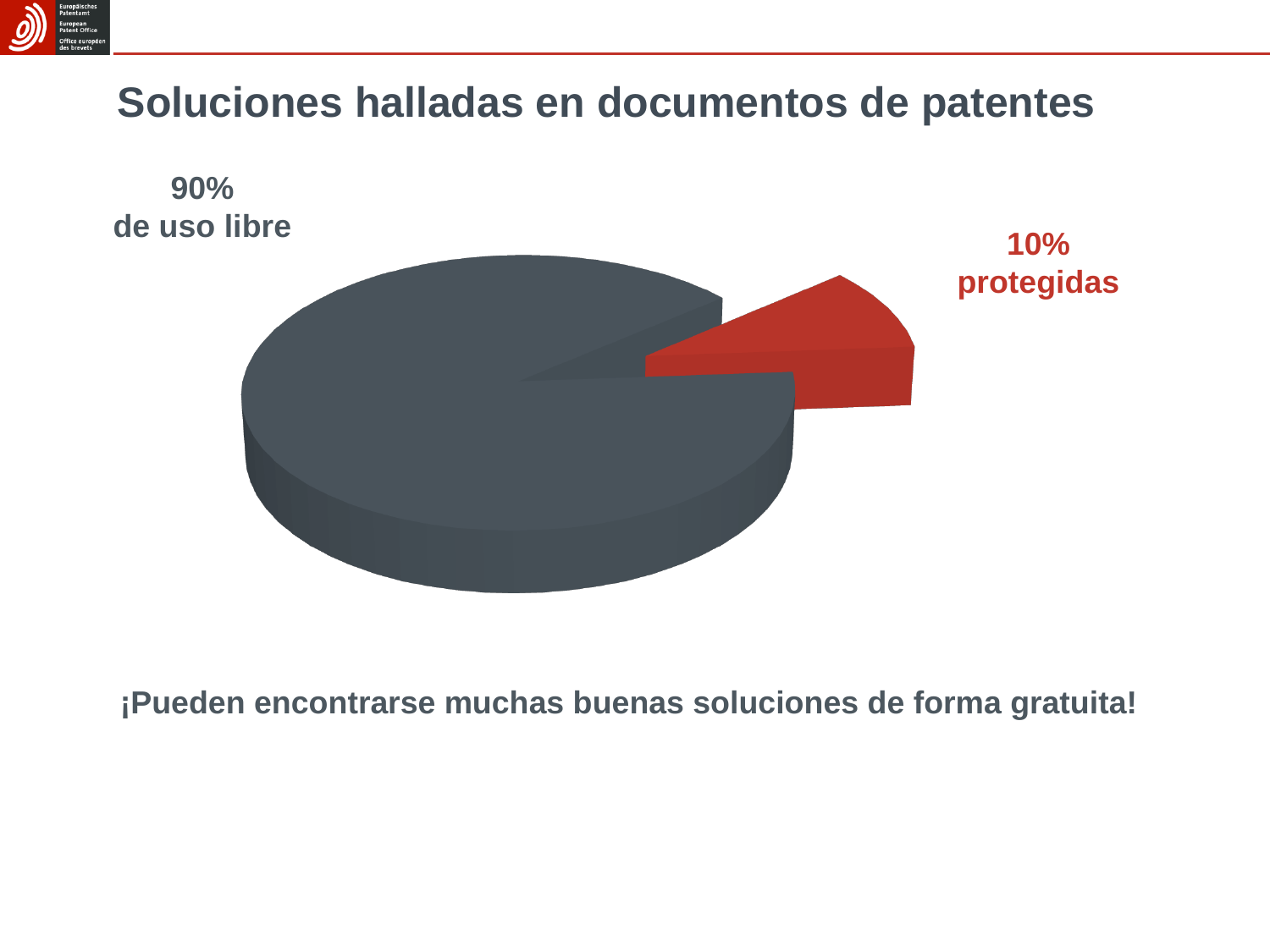
Which slice is the largest? de uso libre What share of the pie is labelled "protegidas"? 10% What kind of chart is shown on the slide? pie chart What is the difference in percentage points between the "de uso libre" slice and the "protegidas" slice? 80 Which is larger, the "protegidas" slice or the "de uso libre" slice? de uso libre What is the title of the slide containing the pie chart? Soluciones halladas en documentos de patentes What share of the pie is labelled "de uso libre"? 90% How many slices does the pie chart have? 2 What colour is the "protegidas" slice? red Which slice is the smallest? protegidas